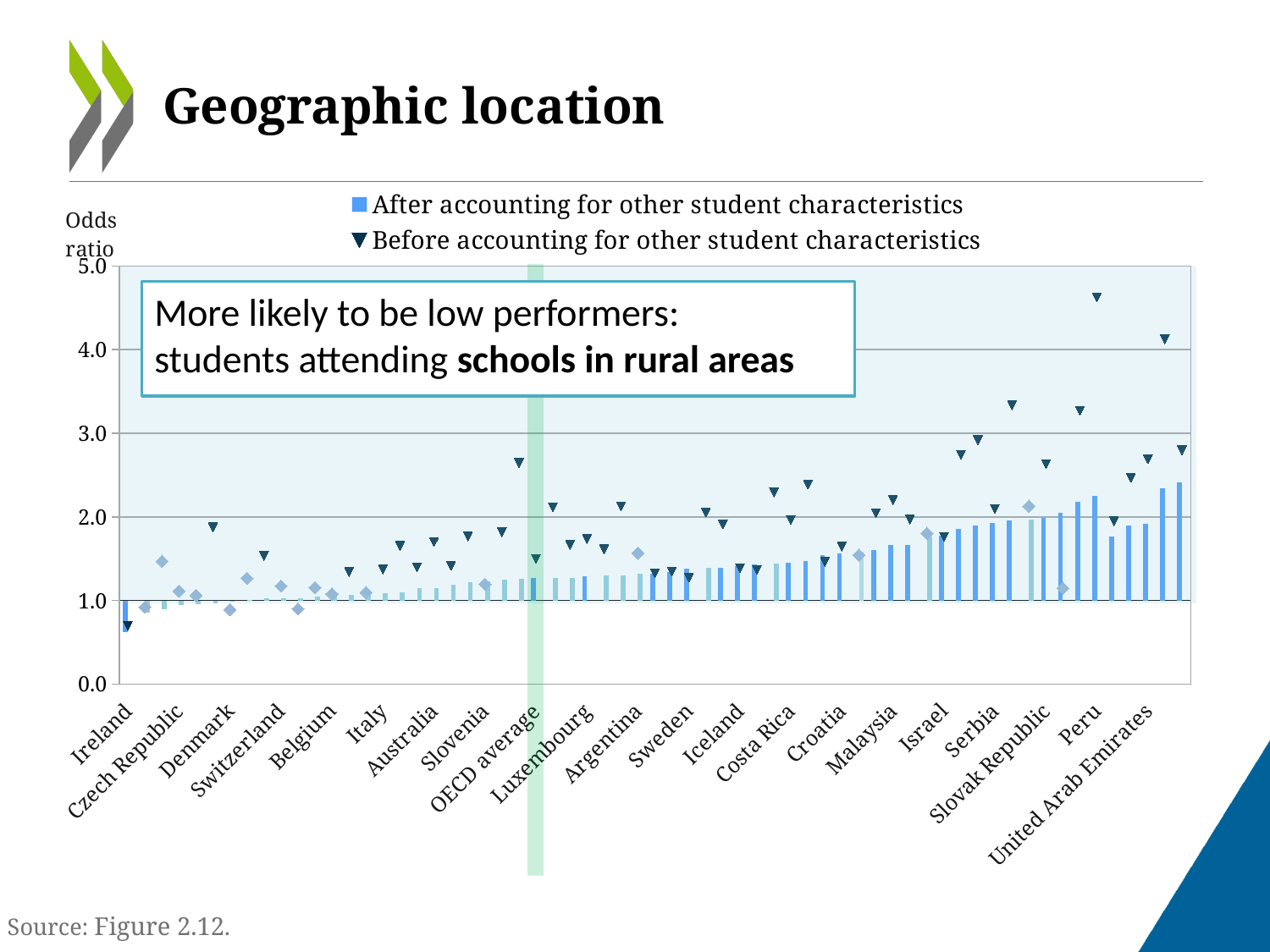
Which country has the lowest 'After accounting for other student characteristics' value? Ireland Is the 'Before accounting for other student characteristics' value for Ireland greater or less than 1.0? less How many series does the legend list? 2 Which is larger: the 'Before accounting for other student characteristics' value for Peru or for Ireland? Peru Which country has the highest 'Before accounting for other student characteristics' value? Peru Is the 'After accounting for other student characteristics' value for Ireland greater or less than 1.0? less What is the label on the vertical axis of the chart? Odds ratio Is the 'Before accounting for other student characteristics' value for Peru greater or less than 4.0? greater What are the two series named in the legend? After accounting for other student characteristics; Before accounting for other student characteristics What kind of chart is shown on the slide? bar chart Do the 'After accounting for other student characteristics' bars generally rise or fall from left to right along the x axis? rise